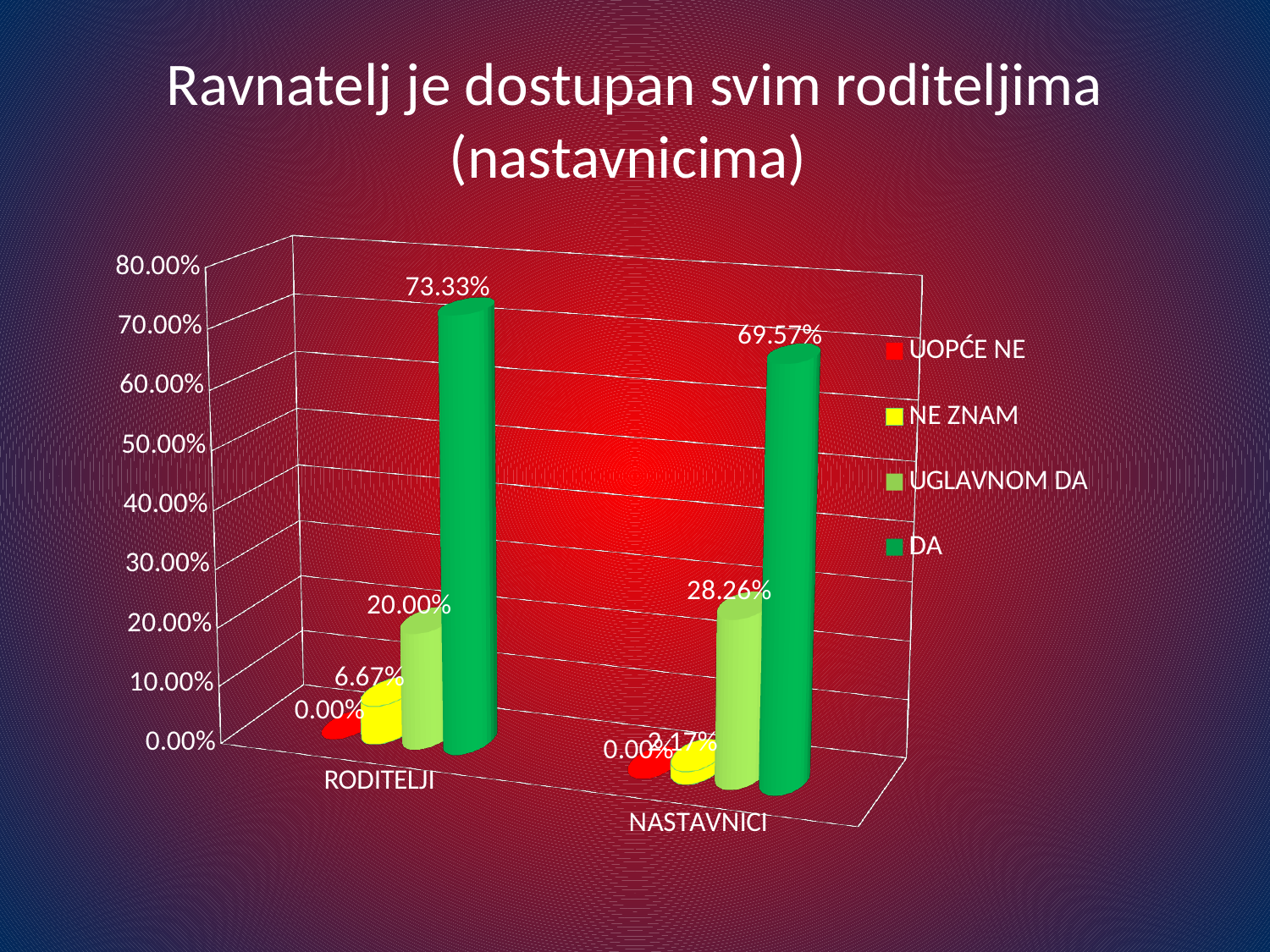
Which series has the highest value in the NASTAVNICI category? DA What is the difference between the DA values for RODITELJI and NASTAVNICI? 3.76% How many series does the legend list? 4 What is the value for DA in the NASTAVNICI category? 69.57% What is the value for UGLAVNOM DA in the NASTAVNICI category? 28.26% Which category has the larger value for DA, RODITELJI or NASTAVNICI? RODITELJI What kind of chart is shown on the slide? bar chart What is the value for UOPĆE NE in the RODITELJI category? 0.00% How many categories are shown on the x axis? 2 What is the difference between the UGLAVNOM DA values for NASTAVNICI and RODITELJI? 8.26% What is the value for NE ZNAM in the RODITELJI category? 6.67% What is the value for DA in the RODITELJI category? 73.33%